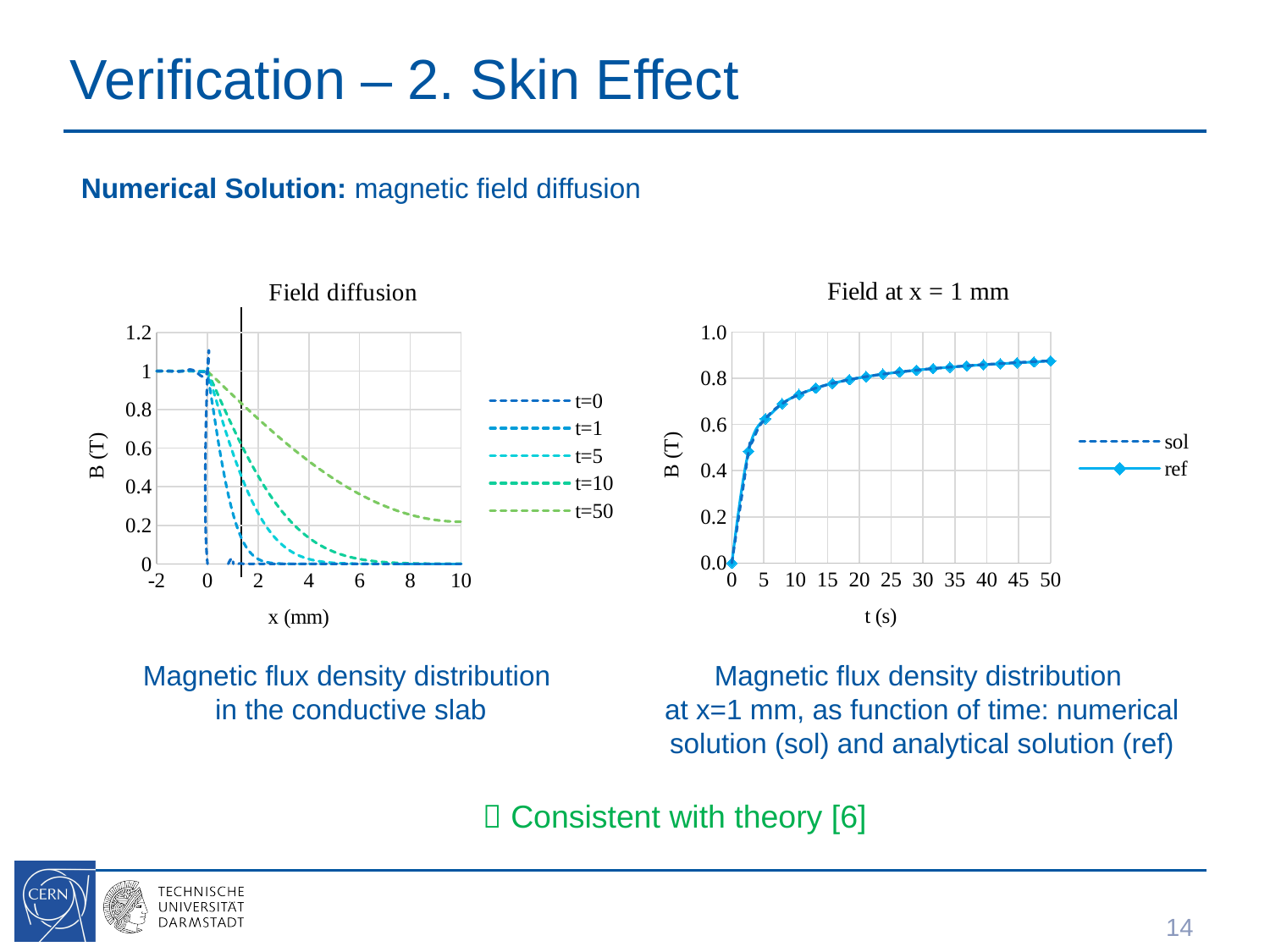
In the "Field at x = 1 mm" chart, do the values rise or fall as t increases? rise What are the legend entries of the "Field diffusion" chart? t=0, t=1, t=5, t=10, t=50 How many series does the legend of the "Field at x = 1 mm" chart list? 2 In the "Field at x = 1 mm" chart, is the value of the ref series at t = 50 s greater or less than 0.8? greater In the "Field diffusion" chart, which series has the highest value at x = 6 mm? t=50 What type of chart is the "Field diffusion" chart? line chart In the "Field diffusion" chart, at x = 4 mm, which series has the larger value, t=50 or t=10? t=50 In the "Field diffusion" chart, what is the label of the x axis? x (mm) How many series does the legend of the "Field diffusion" chart list? 5 In the "Field diffusion" chart, does the t=50 series rise or fall as x increases from 0 to 10 mm? fall In the "Field diffusion" chart, is the value of the t=50 series at x = 8 mm greater or less than 0.2? greater In the "Field diffusion" chart, is the value of the t=10 series at x = 4 mm greater or less than 0.2? less